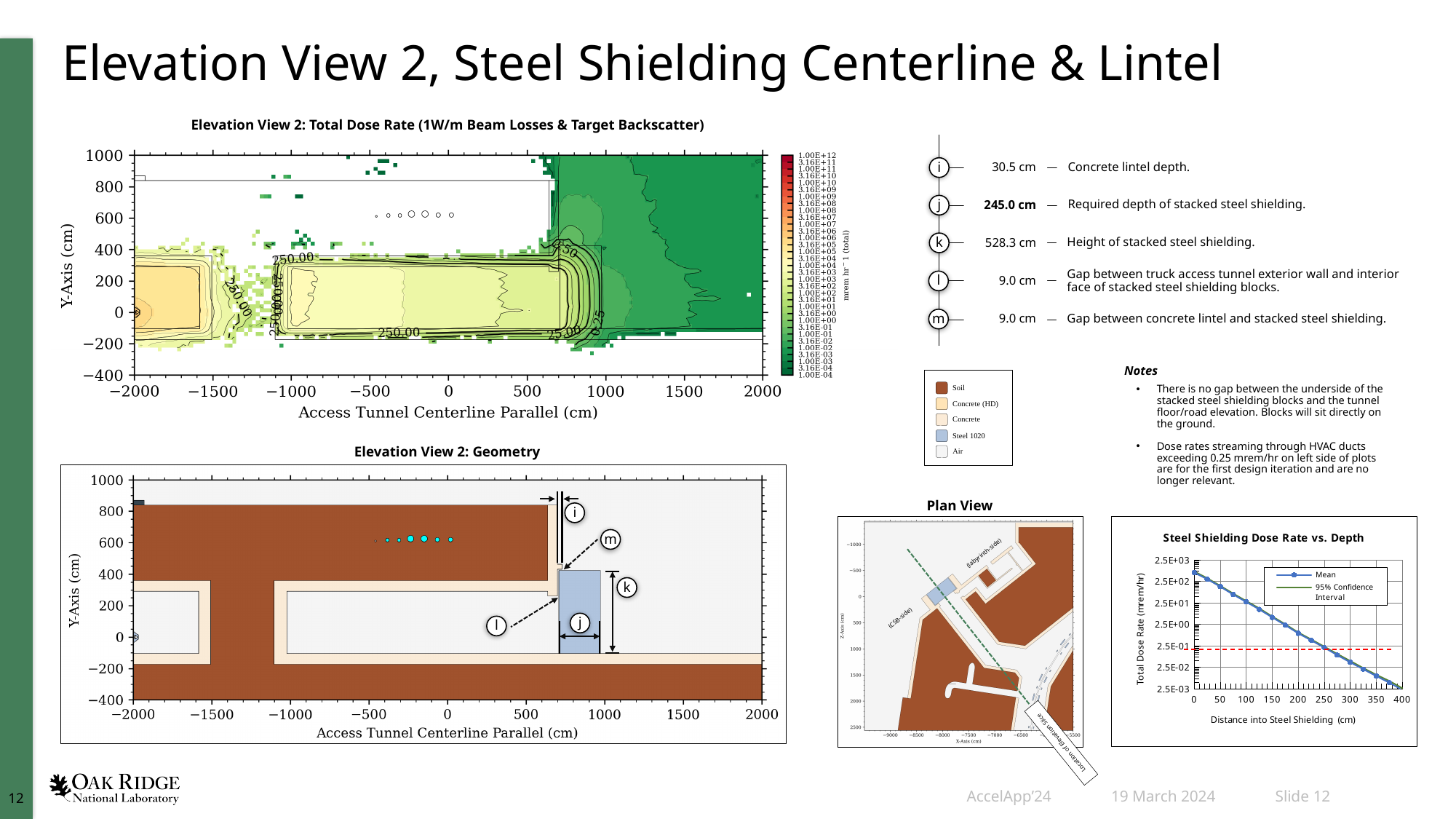
How many series does the legend of the 'Steel Shielding Dose Rate vs. Depth' chart list? 2 In the 'Steel Shielding Dose Rate vs. Depth' chart, is the mean dose rate at 200 cm greater or less than 2.5E-01 mrem/hr? greater In the 'Steel Shielding Dose Rate vs. Depth' chart, what is the maximum value shown on the x axis? 400 In the 'Steel Shielding Dose Rate vs. Depth' chart, what is the x-axis label? Distance into Steel Shielding (cm) In the 'Elevation View 2: Total Dose Rate' contour plot, what is the highest value on the colour scale? 1.00E+12 In the 'Steel Shielding Dose Rate vs. Depth' chart, does the total dose rate rise or fall as distance into the steel shielding increases? fall In the 'Steel Shielding Dose Rate vs. Depth' chart, which distance has the higher mean dose rate, 50 cm or 300 cm? 50 cm What kind of chart is the 'Steel Shielding Dose Rate vs. Depth' chart? line chart What are the two legend entries in the 'Steel Shielding Dose Rate vs. Depth' chart? Mean; 95% Confidence Interval In the 'Steel Shielding Dose Rate vs. Depth' chart, is the mean dose rate at 100 cm greater or less than 2.5E+00 mrem/hr? greater In the 'Steel Shielding Dose Rate vs. Depth' chart, is the mean dose rate at 350 cm greater or less than 2.5E-01 mrem/hr? less In the 'Elevation View 2: Total Dose Rate' contour plot, what is the lowest value on the colour scale? 1.00E-04